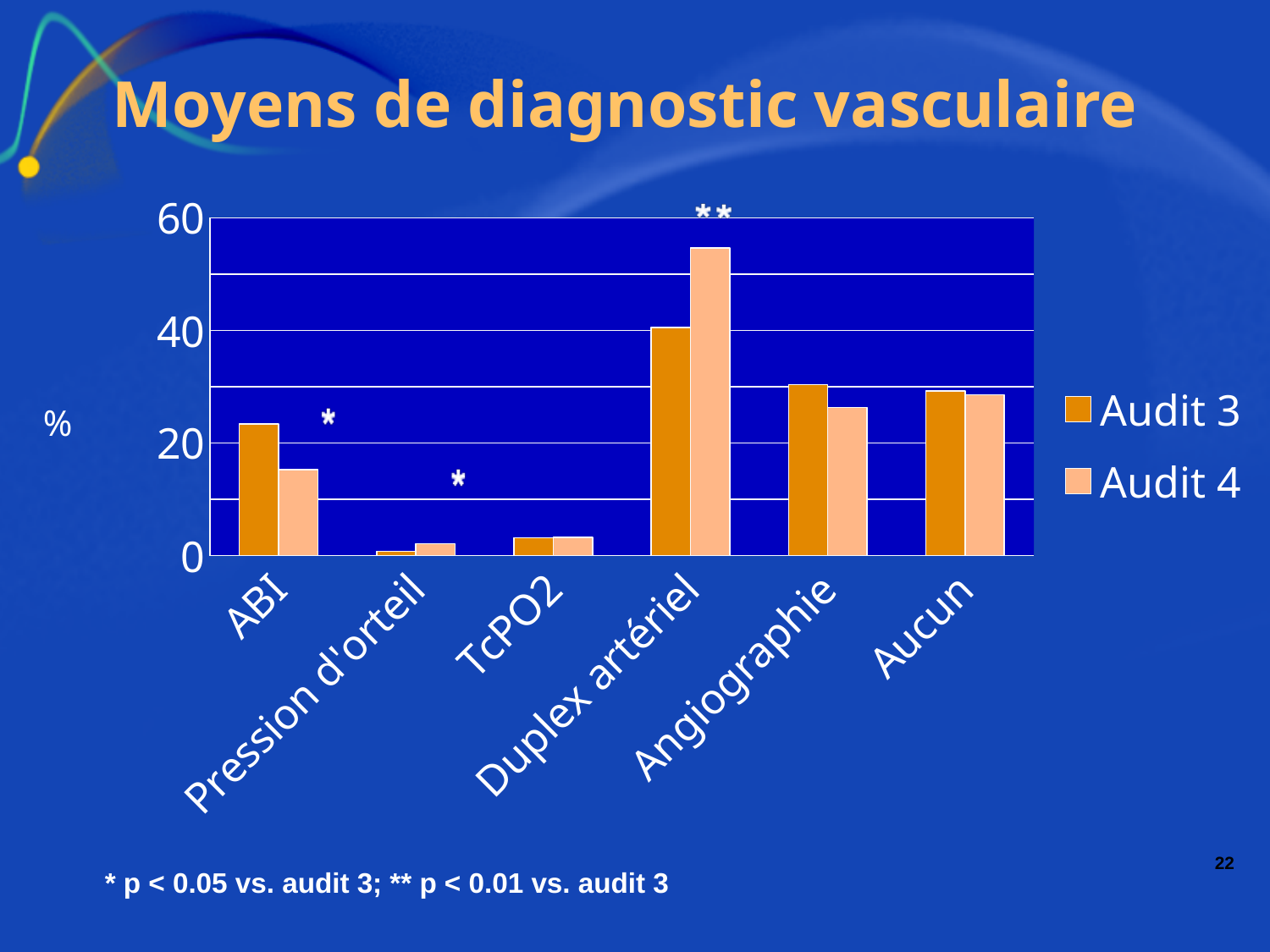
Is the Audit 3 value for ABI greater or less than 20? greater How many series does the legend list? 2 Is the Audit 4 value for ABI greater or less than 20? less Which category has the lowest value for Audit 3? Pression d'orteil Is the Audit 4 value for Duplex artériel greater or less than 50? greater What are the two series named in the legend? Audit 3 and Audit 4 Which category has the highest value for Audit 4? Duplex artériel For ABI, which series has the larger value, Audit 3 or Audit 4? Audit 3 How many categories are shown on the x axis? 6 What kind of chart is shown on the slide? Bar chart Which category has the highest value for Audit 3? Duplex artériel For Duplex artériel, which series has the larger value, Audit 3 or Audit 4? Audit 4